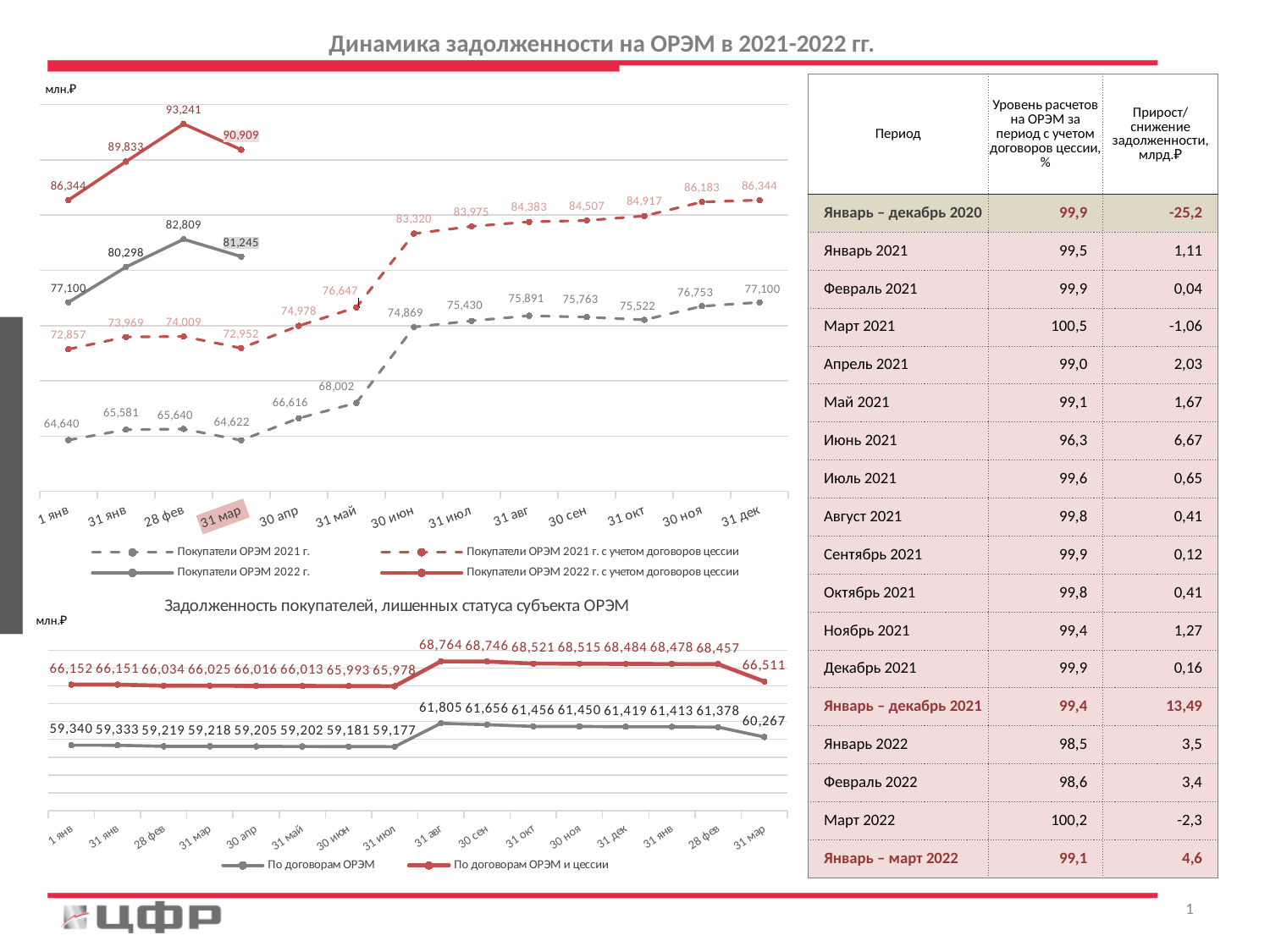
On the top chart, what is the value for Покупатели ОРЭМ 2021 г. с учетом договоров цессии at 30 июн? 83,320 What kind of chart is the bottom chart, Задолженность покупателей, лишенных статуса субъекта ОРЭМ? line chart On the bottom chart (Задолженность покупателей, лишенных статуса субъекта ОРЭМ), which series is higher at 1 янв: По договорам ОРЭМ or По договорам ОРЭМ и цессии? По договорам ОРЭМ и цессии On the top chart, what is the difference between Покупатели ОРЭМ 2022 г. с учетом договоров цессии and Покупатели ОРЭМ 2022 г. at 31 мар? 9,664 On the bottom chart (Задолженность покупателей, лишенных статуса субъекта ОРЭМ), what is the value for По договорам ОРЭМ at the last point, 31 мар? 60,267 On the top chart, what is the value for Покупатели ОРЭМ 2021 г. at 31 дек? 77,100 On the bottom chart (Задолженность покупателей, лишенных статуса субъекта ОРЭМ), what is the value for По договорам ОРЭМ и цессии at 31 авг? 68,764 On the top chart, how many data points does the Покупатели ОРЭМ 2022 г. series have? 4 On the top chart, at which date does the Покупатели ОРЭМ 2021 г. series reach its lowest value? 31 мар On the top chart, what is the value for Покупатели ОРЭМ 2022 г. с учетом договоров цессии at 28 фев? 93,241 On the top chart, how many series does the legend list? 4 On the bottom chart (Задолженность покупателей, лишенных статуса субъекта ОРЭМ), what is the difference between По договорам ОРЭМ и цессии and По договорам ОРЭМ at 31 июл? 6,801